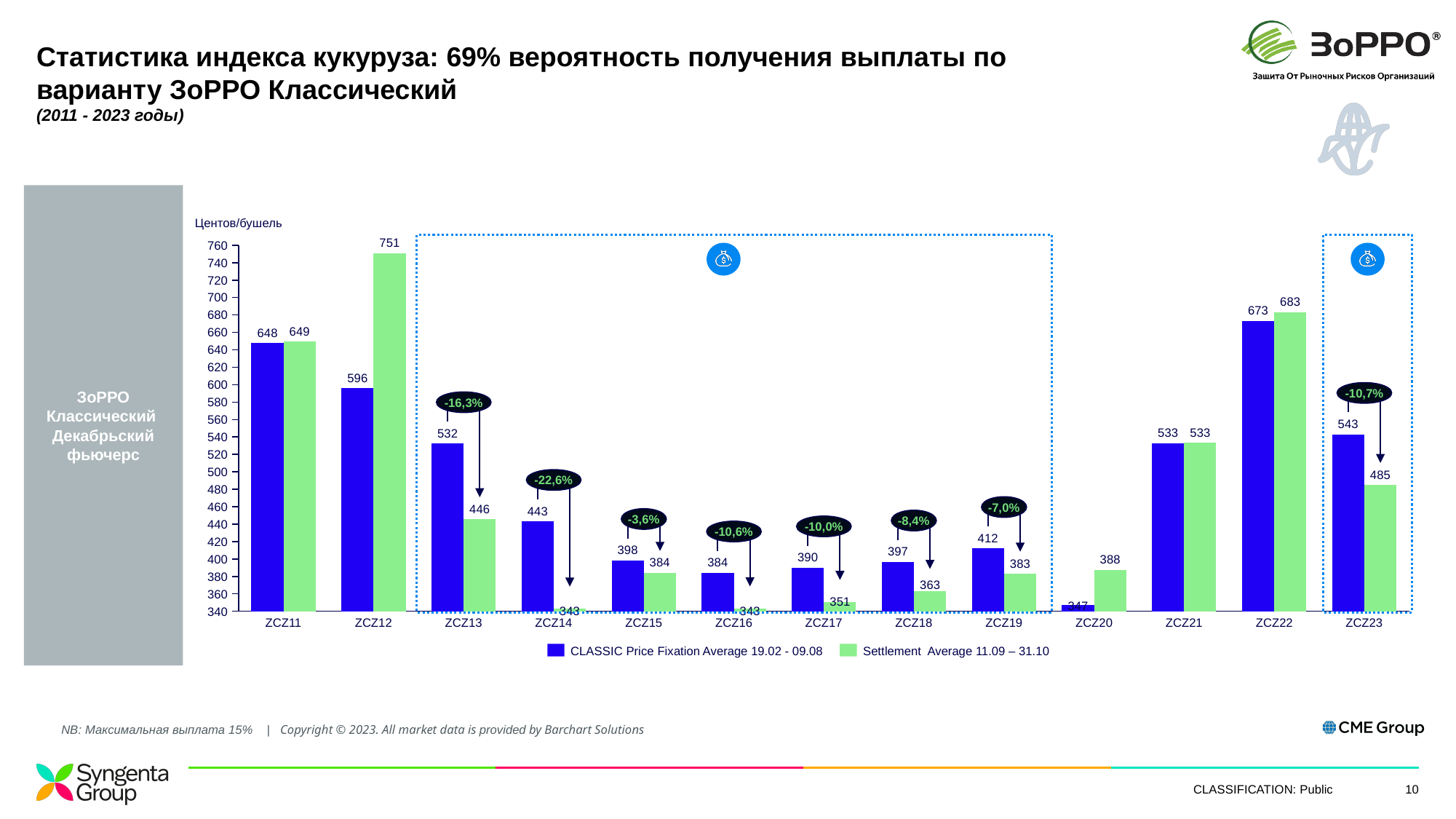
Which category has the lowest CLASSIC Price Fixation Average value? ZCZ20 What is the difference between the CLASSIC Price Fixation Average and the Settlement Average for ZCZ13? 86 How many series does the legend list? 2 What is the Settlement Average value for ZCZ23? 485 How many categories are shown on the x axis? 13 What kind of chart is shown on the slide? Bar chart Is the CLASSIC Price Fixation Average value for ZCZ22 greater or less than 600? greater What is the Settlement Average value for ZCZ20? 388 Which category has the highest Settlement Average value? ZCZ12 What unit is shown above the y axis of the chart? Центов/бушель What is the CLASSIC Price Fixation Average value for ZCZ13? 532 Which is larger for ZCZ12: the CLASSIC Price Fixation Average or the Settlement Average? Settlement Average